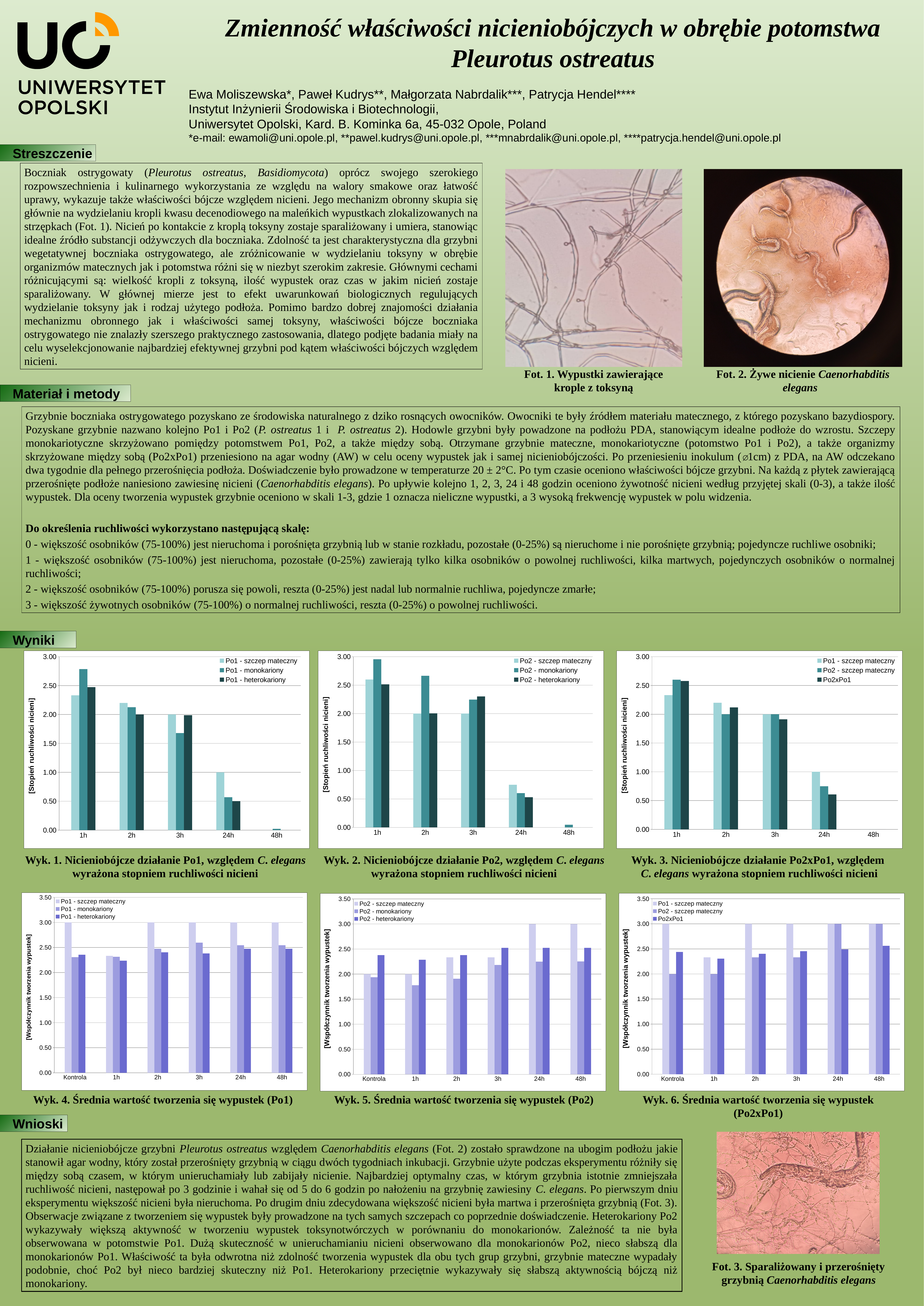
In Wyk. 2, is the value for Po2 - monokariony at 1h greater or less than 2.50? greater In Wyk. 2, do the values for Po2 - szczep mateczny rise or fall from 1h to 48h? fall In Wyk. 3, at 24h, which is larger: Po1 - szczep mateczny or Po2xPo1? Po1 - szczep mateczny How many series does the legend of Wyk. 1 list? 3 How many time categories are shown on the x axis of Wyk. 1? 5 In Wyk. 1, which series has the highest value at 1h? Po1 - monokariony In Wyk. 6, is the value for Po2 - szczep mateczny at Kontrola greater or less than 2.50? less How many categories are shown on the x axis of Wyk. 4? 6 In Wyk. 1, is the value for Po1 - szczep mateczny at 1h greater or less than 2.00? greater In Wyk. 3, what is the value for Po1 - szczep mateczny at 24h? 1.00 What kind of chart is Wyk. 1 (Nicieniobójcze działanie Po1)? bar chart In Wyk. 5, which series has the highest value at 1h? Po2 - heterokariony